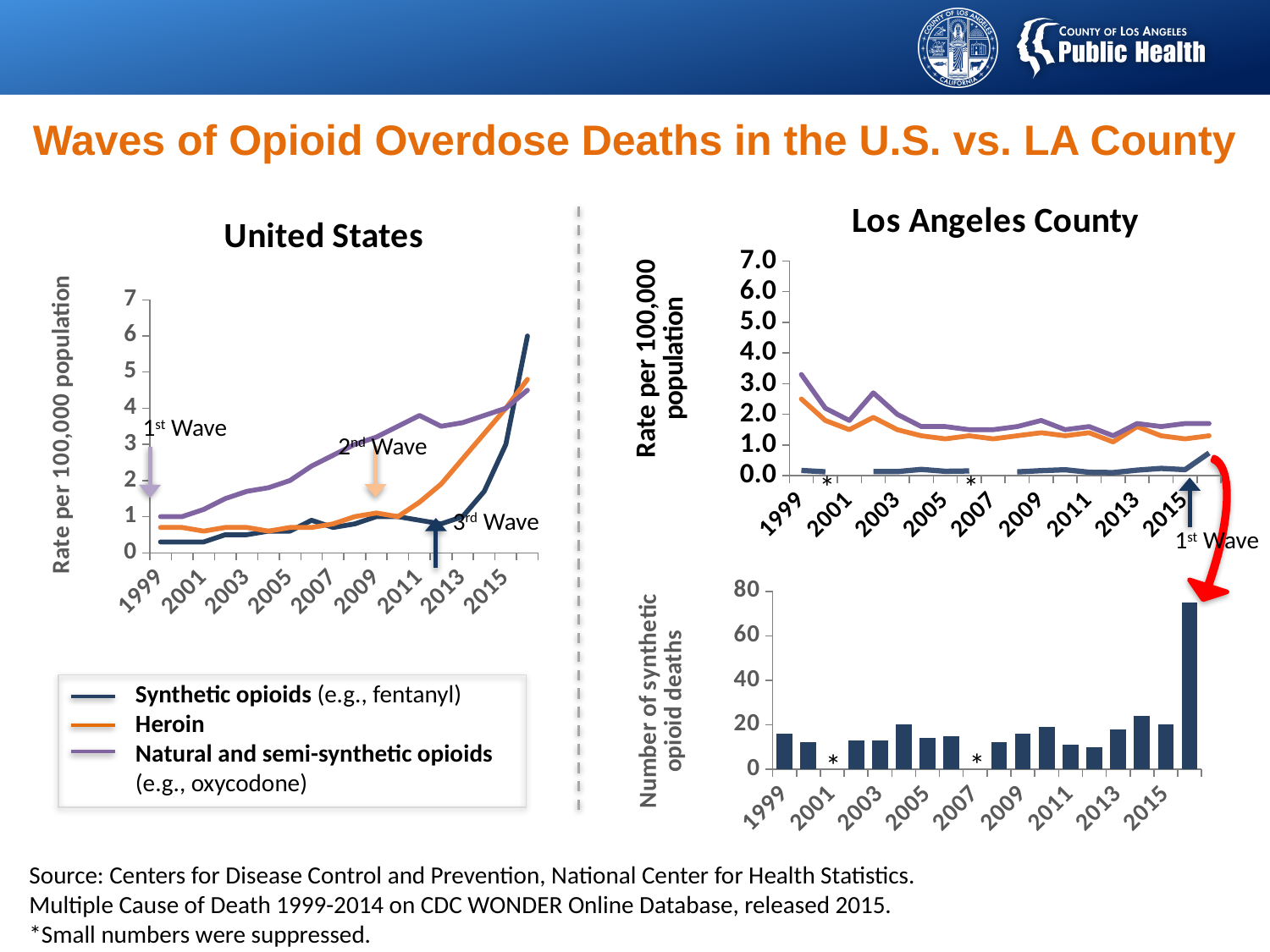
What kind of chart is the bottom-right chart showing the number of synthetic opioid deaths in Los Angeles County? bar chart In the United States chart, does the Synthetic opioids line rise or fall between 2013 and 2015? rise In the United States chart, is the value for Natural and semi-synthetic opioids in 2011 greater or less than 3? greater How many series does the legend list for the United States chart? 3 According to the footnote, what does the asterisk (*) on the Los Angeles County charts indicate? Small numbers were suppressed In the United States chart, is the peak value of the Synthetic opioids line greater or less than 5? greater What kind of chart is the United States chart? line chart In the Los Angeles County bar chart of synthetic opioid deaths, is the tallest bar greater or less than 60? greater In the United States chart, which series has the higher value in 2003: Heroin or Natural and semi-synthetic opioids? Natural and semi-synthetic opioids In the Los Angeles County rate chart, which series has the highest value in 1999? Natural and semi-synthetic opioids